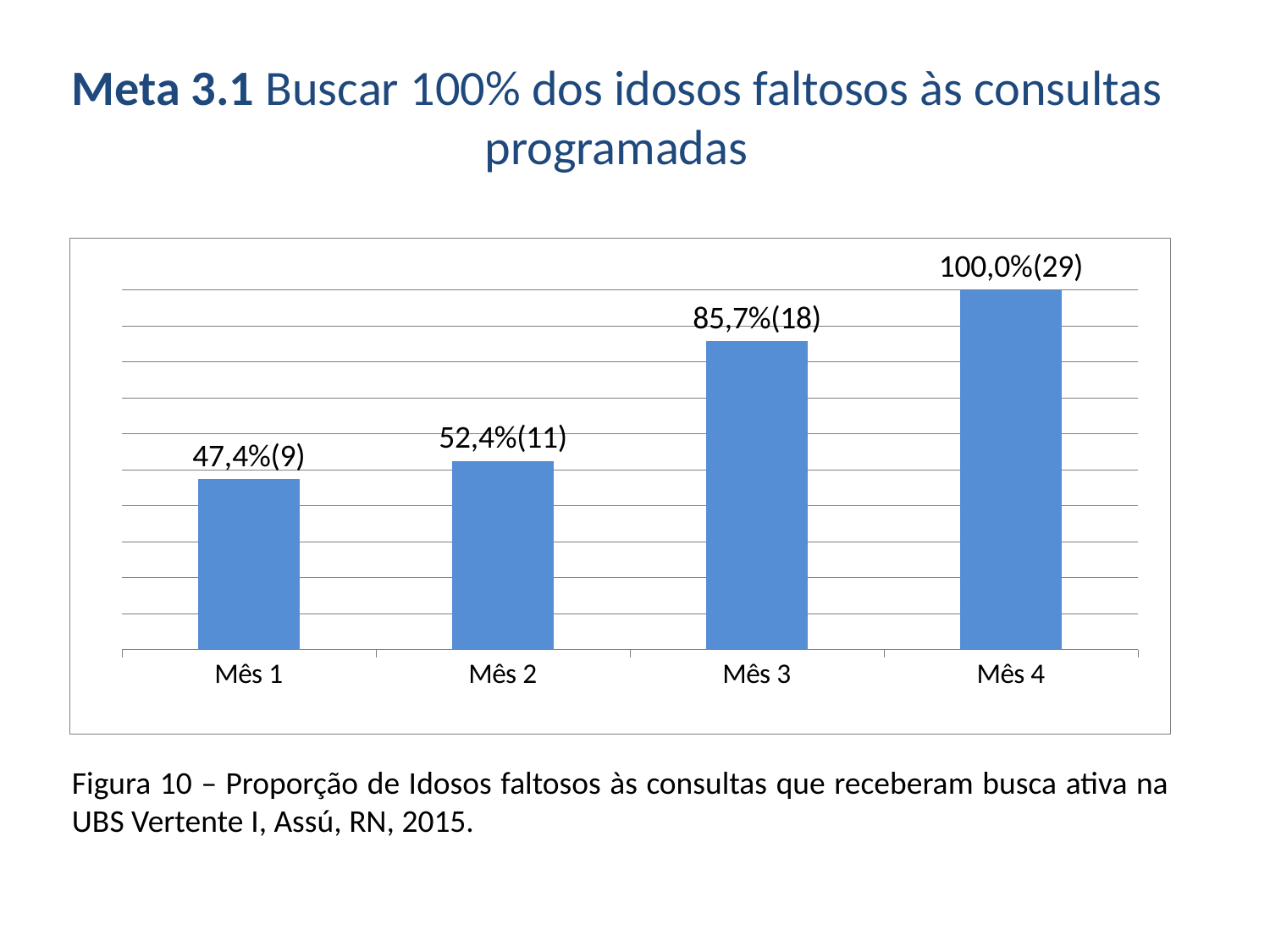
Which month has the lowest value? Mês 1 What is the value shown for Mês 1? 47,4%(9) Which is larger, the value for Mês 2 or the value for Mês 3? Mês 3 What kind of chart is shown on the slide? Bar chart How many elderly people are shown in parentheses for Mês 2? 11 How many months (categories) are shown on the x axis? 4 What is the value shown for Mês 3? 85,7%(18) Which month has the highest value? Mês 4 Do the values rise or fall from Mês 1 to Mês 4? Rise What percentage is shown for Mês 4? 100,0% What is the difference in percentage points between Mês 4 and Mês 3? 14,3 What is the difference in percentage points between Mês 2 and Mês 1? 5,0